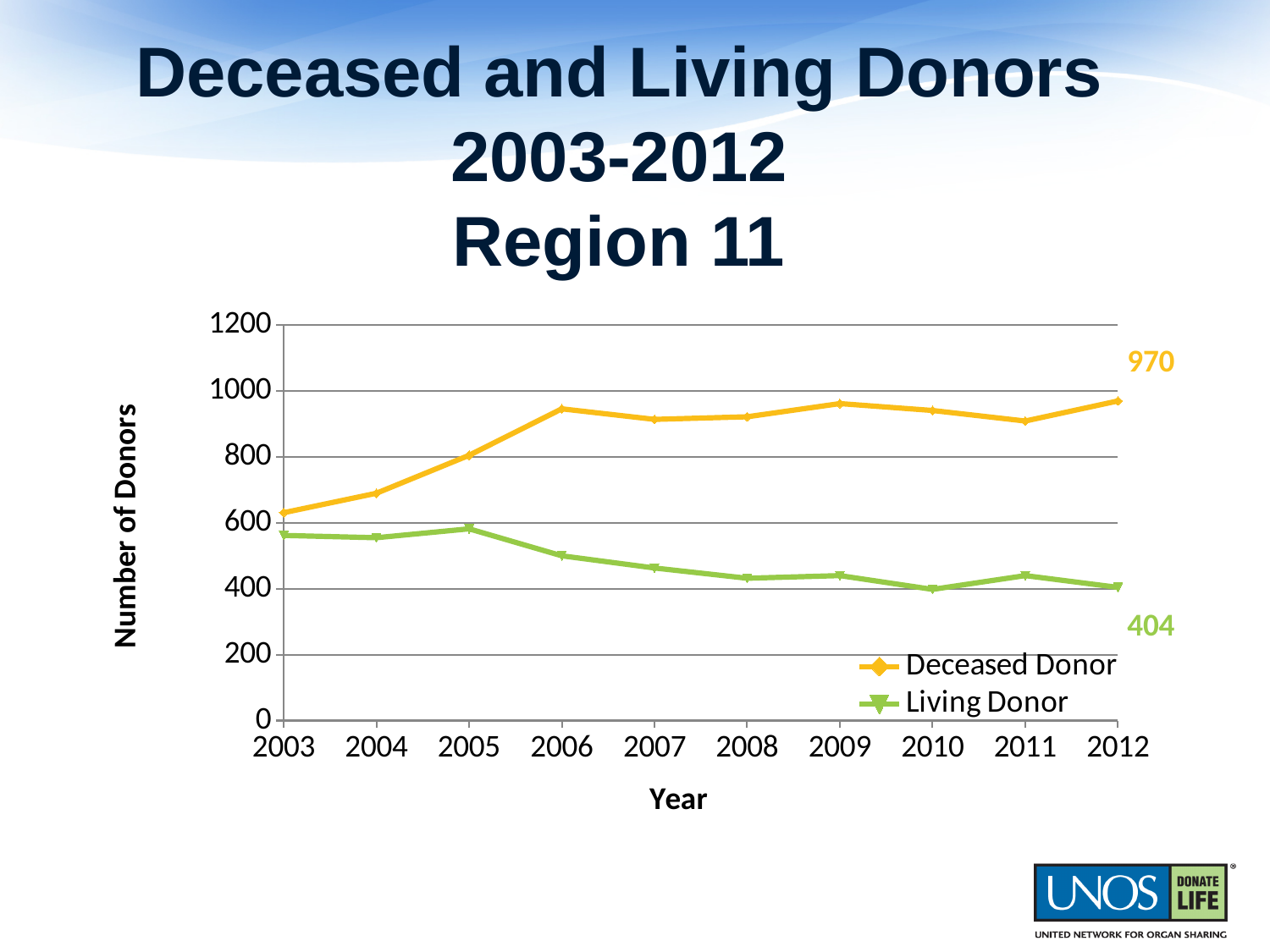
Is the value for Living Donor in 2010 greater or less than 600? less Which year has the lowest Deceased Donor value? 2003 How many years are shown on the x axis? 10 Is the value for Deceased Donor in 2009 greater or less than 800? greater What is the value for Living Donor in 2012? 404 Is the value for Deceased Donor in 2003 greater or less than 800? less What kind of chart is shown on the slide? line chart What is the value for Deceased Donor in 2012? 970 What is the difference between the Deceased Donor and Living Donor values in 2012? 566 In 2012, which series has the larger value, Deceased Donor or Living Donor? Deceased Donor How many series does the legend list? 2 Does the Living Donor series generally rise or fall from 2003 to 2012? fall